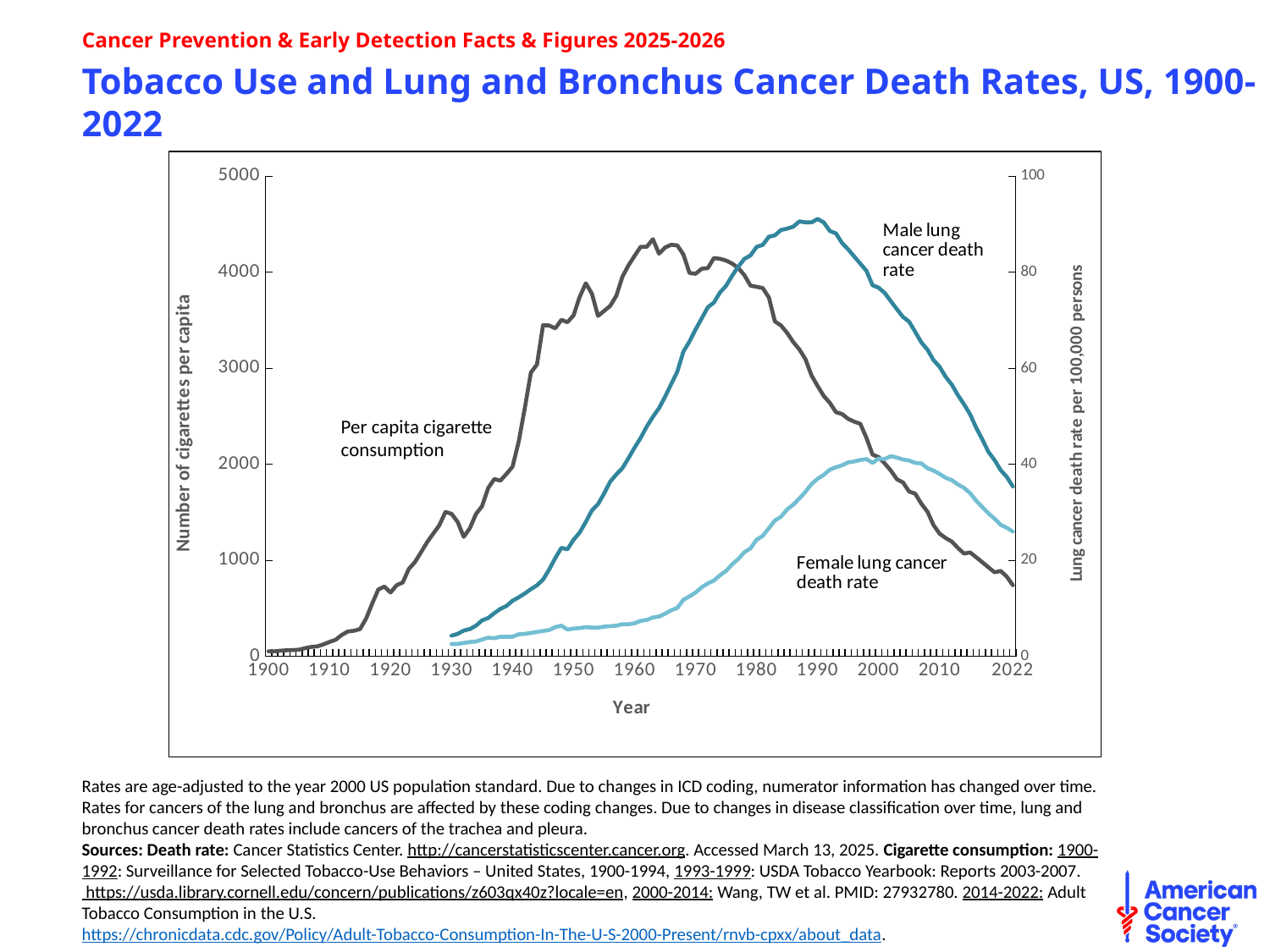
What kind of chart is shown on the slide? line chart How many data series are plotted on the chart? 3 What is the label of the right vertical axis? Lung cancer death rate per 100,000 persons Is the male lung cancer death rate in 2022 greater or less than 40? less Is the per capita cigarette consumption in 1960 greater or less than 4000? greater Does the per capita cigarette consumption rise or fall between 1980 and 2022? fall Is the male lung cancer death rate in 1990 greater or less than 80? greater Does the female lung cancer death rate rise or fall between 1930 and 1990? rise In 2022, which is higher: the male lung cancer death rate or the female lung cancer death rate? Male lung cancer death rate What is the label of the left vertical axis? Number of cigarettes per capita